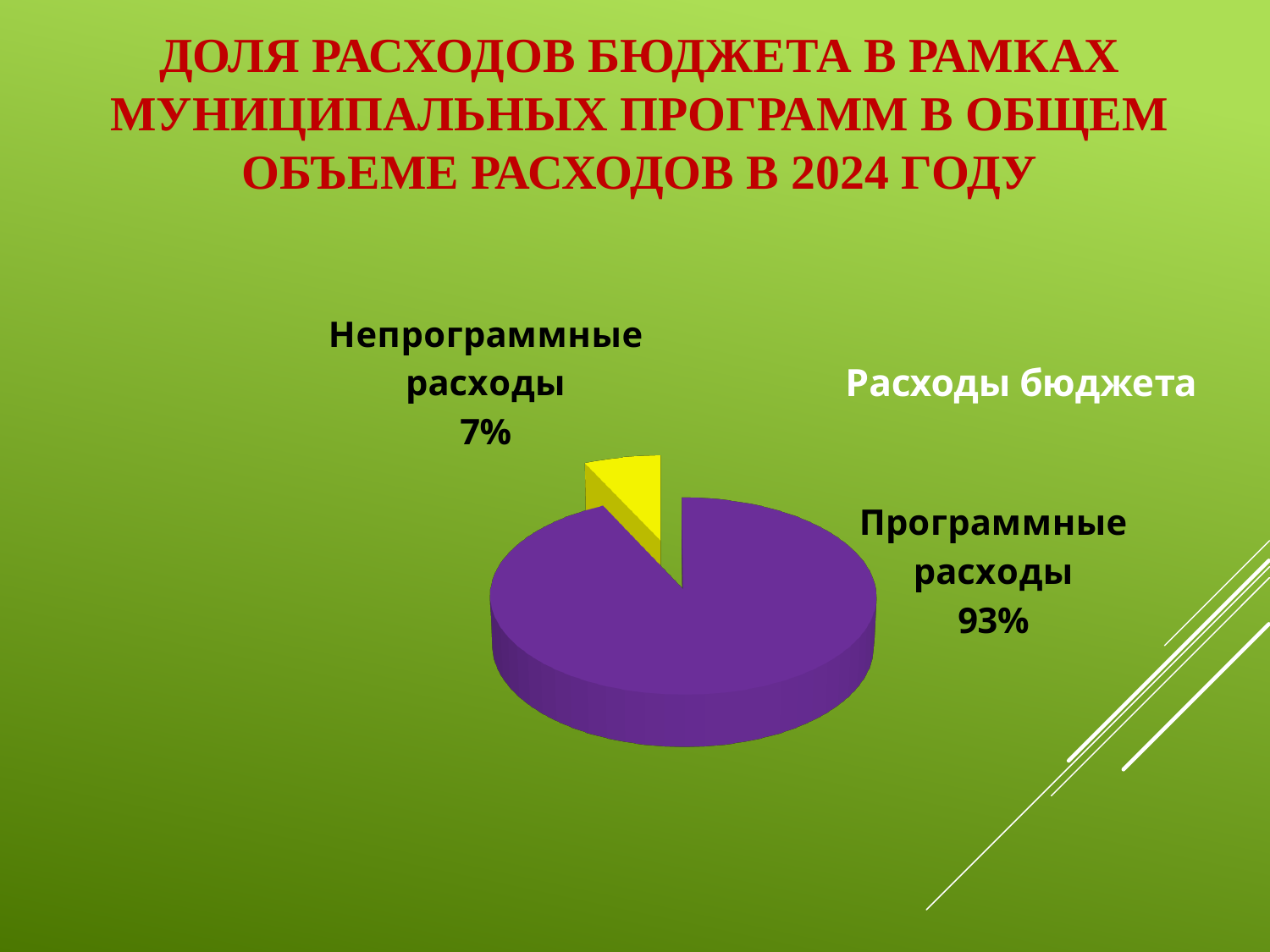
What share of the pie is labelled "Непрограммные расходы"? 7% What colour is the "Непрограммные расходы" slice? Yellow Is the share for "Программные расходы" greater or less than 50%? greater How many slices does the pie chart have? 2 What share of the pie is labelled "Программные расходы"? 93% What is the title of the chart? Расходы бюджета What is the difference in percentage points between the "Программные расходы" and "Непрограммные расходы" slices? 86 Which slice of the pie is the smallest? Непрограммные расходы Which slice of the pie is the largest? Программные расходы What kind of chart is shown on the slide? Pie chart Is the share for "Непрограммные расходы" greater or less than 10%? less Which is larger: the "Программные расходы" slice or the "Непрограммные расходы" slice? Программные расходы